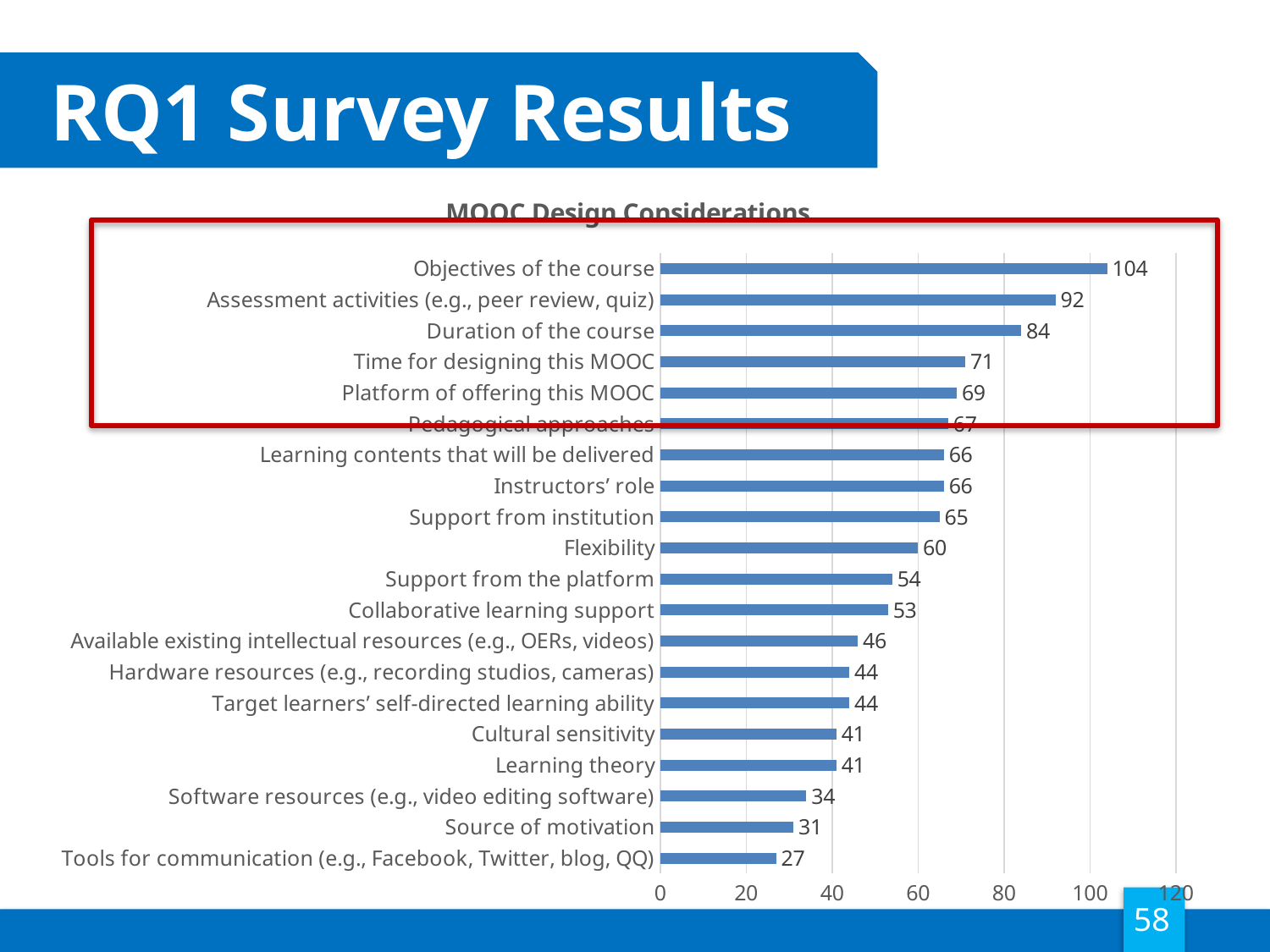
Which category has the highest value? Objectives of the course How many categories are plotted in the chart? 20 What is the value for Source of motivation? 31 What is the value for Flexibility? 60 Is the value for Support from the platform greater or less than 60? less What is the difference between the values for Objectives of the course and Assessment activities (e.g., peer review, quiz)? 12 Which category has the lowest value? Tools for communication (e.g., Facebook, Twitter, blog, QQ) Which is larger, the value for Duration of the course or the value for Time for designing this MOOC? Duration of the course What is the value for Cultural sensitivity? 41 What kind of chart is shown on the slide? bar chart What is the title of the chart? MOOC Design Considerations What is the value for Objectives of the course? 104